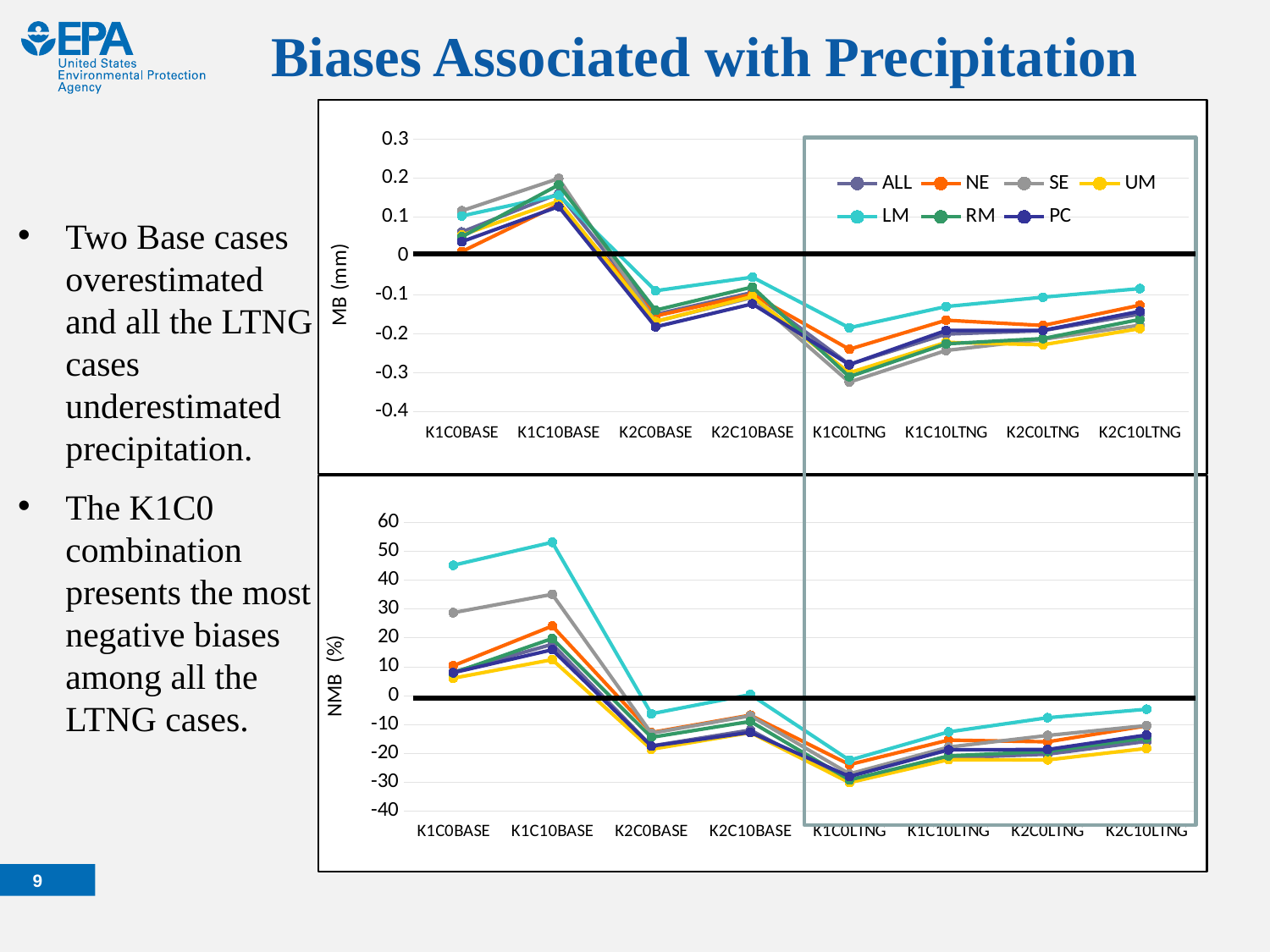
How many series does the legend of the top chart list? 7 In the top chart (MB (mm)), is the LM value for K2C10BASE greater or less than -0.1? greater How many categories are shown on the x axis of the bottom chart (NMB (%))? 8 What kind of chart is the top chart (MB (mm))? line chart In the bottom chart (NMB (%)), which series has the highest value at K1C10BASE? LM In the bottom chart (NMB (%)), which is larger at K1C0BASE: the LM value or the SE value? LM In the bottom chart (NMB (%)), at which category does the LM series reach its highest value? K1C10BASE In the bottom chart (NMB (%)), is the LM value for K1C0BASE greater or less than 40? greater In the bottom chart (NMB (%)), is the LM value for K1C10BASE greater or less than 50? greater In the top chart (MB (mm)), do the values rise or fall from K1C10BASE to K2C0BASE? fall What is the y-axis label of the bottom chart? NMB (%)